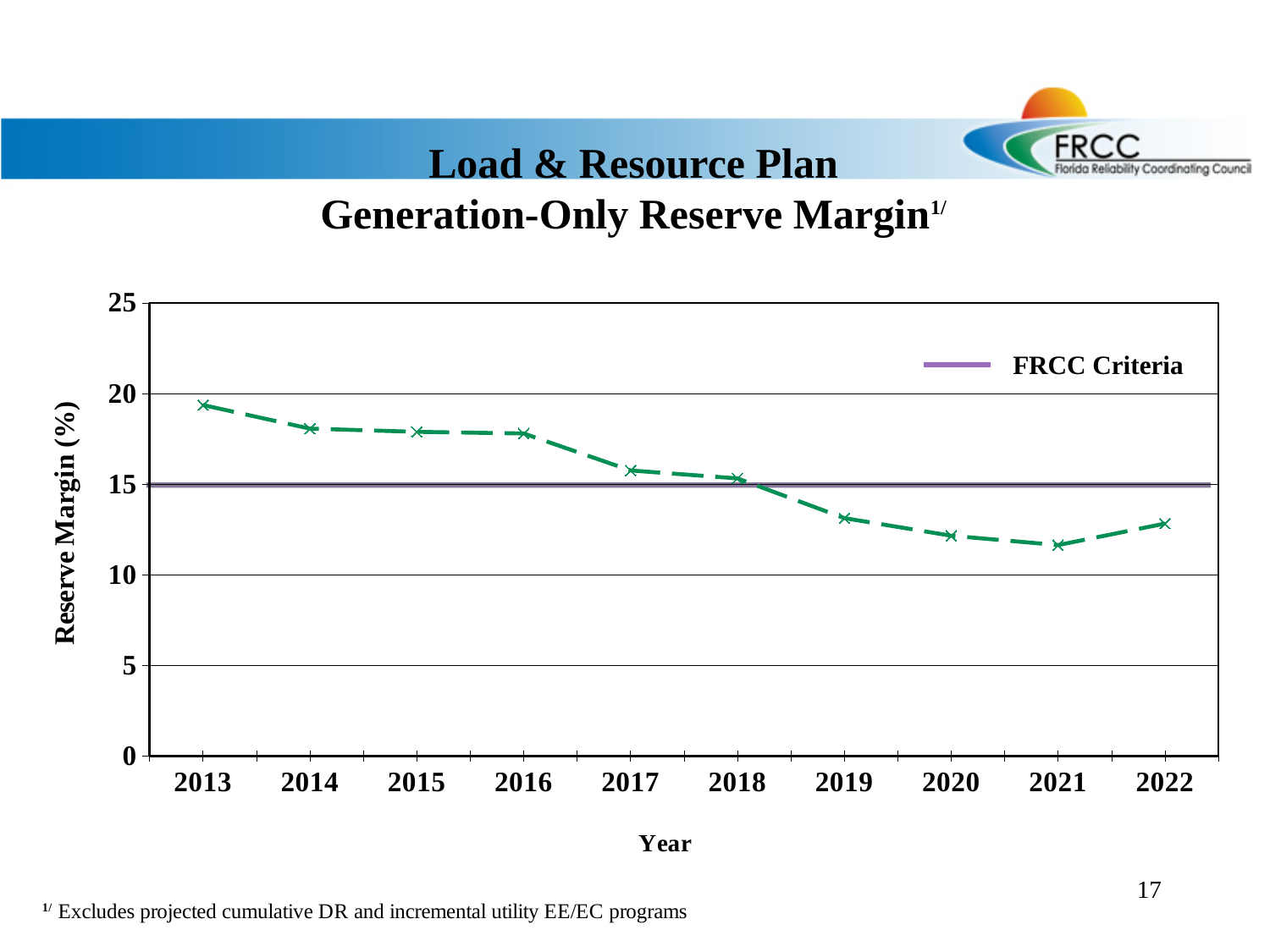
Which year has the larger reserve margin, 2013 or 2022? 2013 What is the label on the y axis of the chart? Reserve Margin (%) Is the reserve margin for 2020 greater or less than 10? greater Is the reserve margin for 2013 greater or less than 15? greater Does the reserve margin generally rise or fall from 2013 to 2021? fall Is the reserve margin for 2013 greater or less than 20? less What kind of chart is shown on the slide? line chart At what reserve margin value is the FRCC Criteria line drawn? 15 Which year has the highest generation-only reserve margin? 2013 Which year has the lowest generation-only reserve margin? 2021 How many years are plotted along the x axis? 10